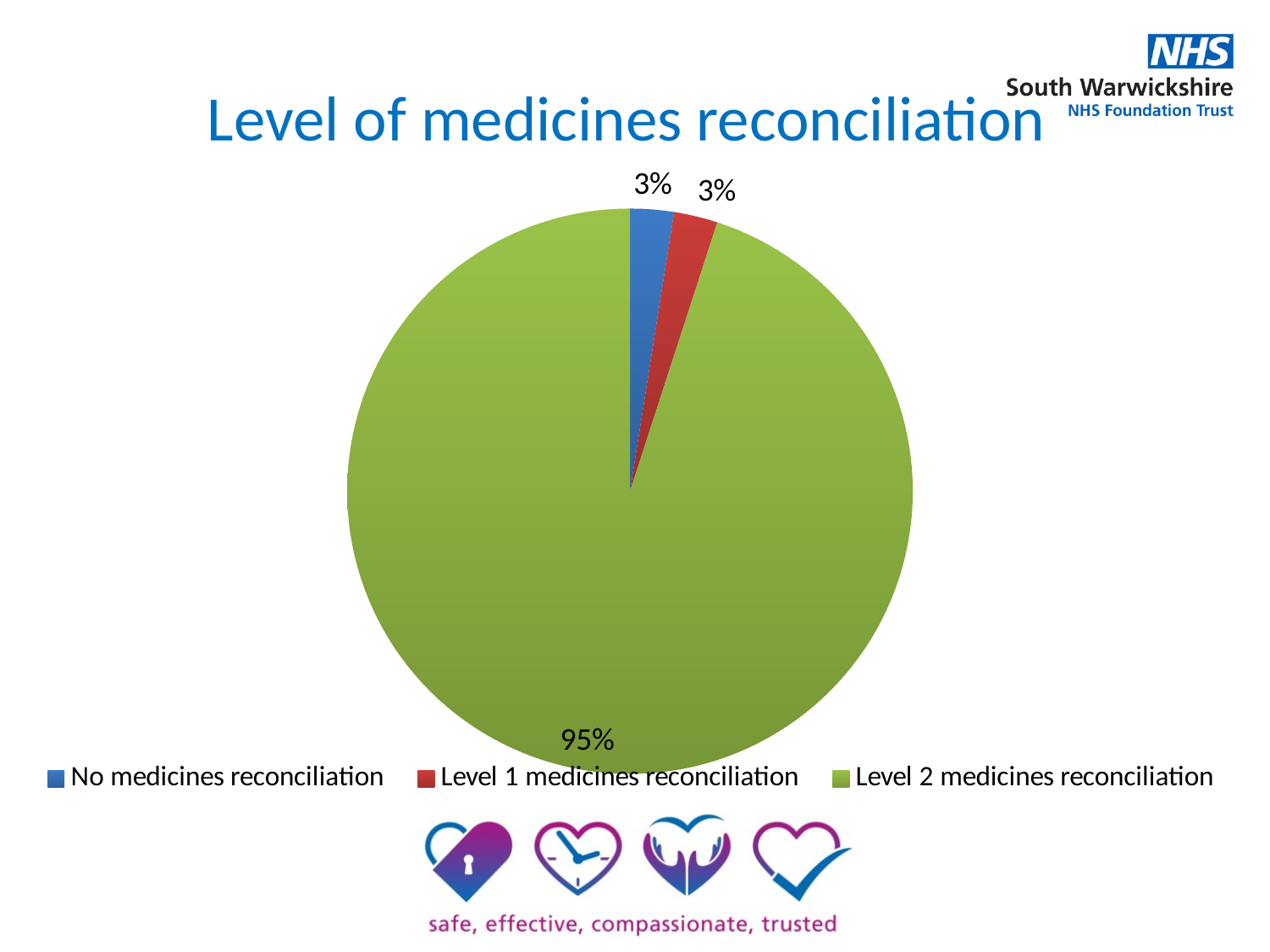
What share of the pie is No medicines reconciliation? 3% What is the difference between the Level 2 medicines reconciliation share and the Level 1 medicines reconciliation share? 92% Which category has the largest slice of the pie? Level 2 medicines reconciliation What colour is the Level 2 medicines reconciliation slice? green Which is larger, the Level 2 medicines reconciliation slice or the No medicines reconciliation slice? Level 2 medicines reconciliation What share of the pie is Level 1 medicines reconciliation? 3% How many entries does the legend list? 3 What share of the pie is Level 2 medicines reconciliation? 95% What kind of chart is shown on the slide? pie chart What is the title of the chart? Level of medicines reconciliation How many slices does the pie chart have? 3